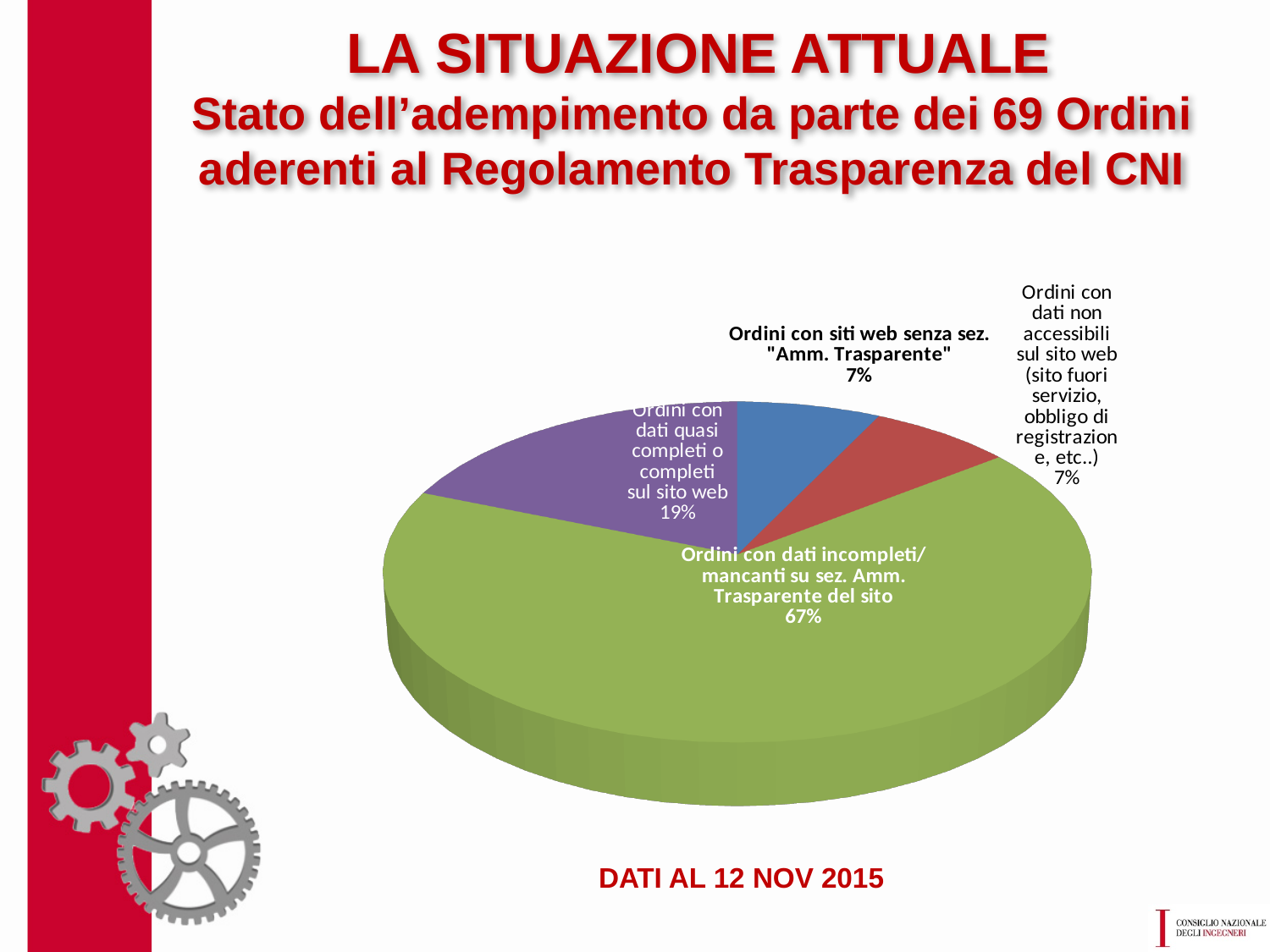
What share of the pie is labelled "Ordini con dati incompleti/mancanti su sez. Amm. Trasparente del sito"? 67% What date is given for the data below the chart? 12 NOV 2015 Which is larger: the slice for "Ordini con dati quasi completi o completi sul sito web" or the slice for "Ordini con siti web senza sez. 'Amm. Trasparente'"? Ordini con dati quasi completi o completi sul sito web What share of the pie is labelled "Ordini con dati quasi completi o completi sul sito web"? 19% What is the combined share of the two slices labelled 7%? 14% What kind of chart is shown on the slide? Pie chart How many slices does the pie chart have? 4 What share of the pie is labelled "Ordini con dati non accessibili sul sito web"? 7% What is the difference in percentage points between the "Ordini con dati incompleti/mancanti" slice and the "Ordini con dati quasi completi o completi" slice? 48 percentage points What colour is the largest slice of the pie chart? Green Which category has the largest slice of the pie? Ordini con dati incompleti/mancanti su sez. Amm. Trasparente del sito